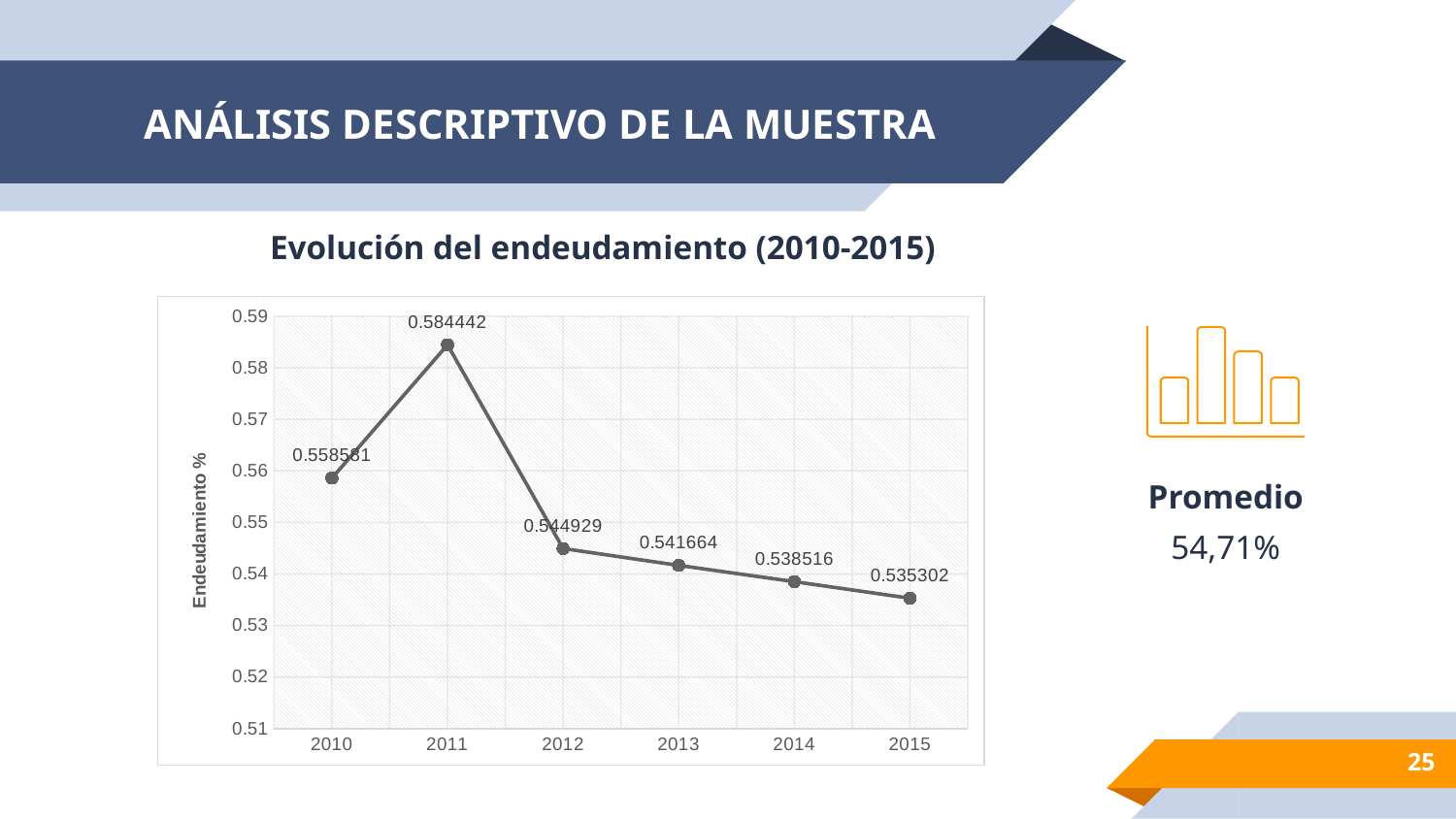
What type of chart is shown on the slide? Line chart What is the value for 2015? 0.535302 How many years are plotted on the x axis? 6 What is the difference between the values for 2011 and 2015? 0.04914 Which year has the lowest value? 2015 What is the value for 2011? 0.584442 What is the value for 2012? 0.544929 What is the value for 2013? 0.541664 Which is larger, the value for 2012 or the value for 2014? 2012 Is the value for 2010 greater or less than 0.55? greater What is the title of the chart? Evolución del endeudamiento (2010-2015) Which year has the highest value? 2011